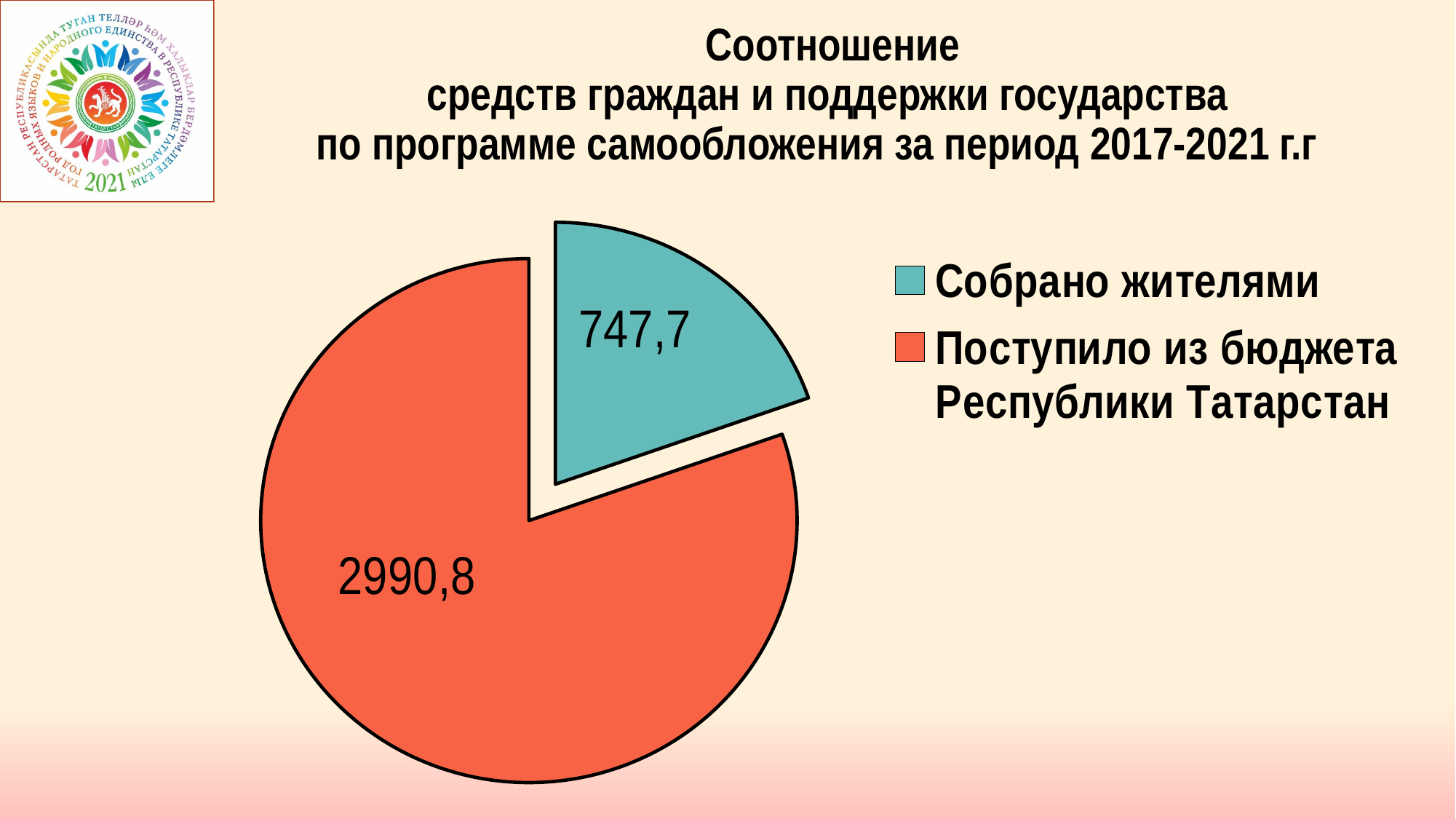
How many entries does the legend list? 2 How many slices does the pie chart have? 2 What colour is the slice for "Собрано жителями"? teal Which category has the largest slice of the pie? Поступило из бюджета Республики Татарстан Which category has the smallest slice of the pie? Собрано жителями What is the total of the two values shown in the pie chart? 3738,5 What type of chart is shown on the slide? pie chart What is the value for "Собрано жителями"? 747,7 What is the value for "Поступило из бюджета Республики Татарстан"? 2990,8 What is the difference between the value for "Поступило из бюджета Республики Татарстан" and the value for "Собрано жителями"? 2243,1 What share of the pie does "Собрано жителями" represent? 20% Which is larger: "Собрано жителями" or "Поступило из бюджета Республики Татарстан"? Поступило из бюджета Республики Татарстан